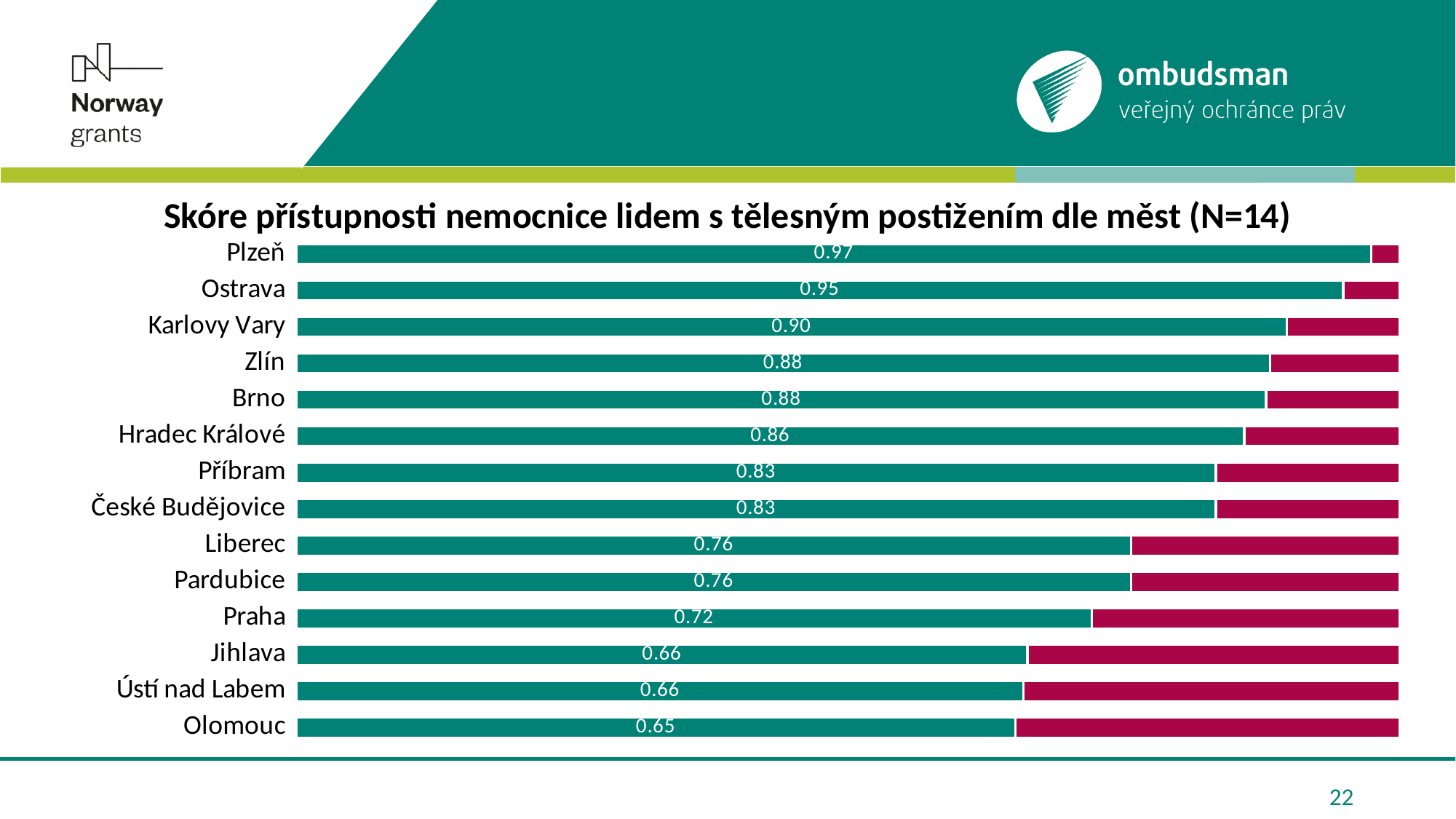
What is the accessibility score for Hradec Králové? 0.86 Which has a higher score, Příbram or Praha? Příbram How many cities are shown in the chart? 14 Which city has the highest accessibility score? Plzeň What is the difference between the scores of Ostrava and Karlovy Vary? 0.05 What is the accessibility score for Plzeň? 0.97 What kind of chart is shown on the slide? Bar chart What is the accessibility score for Praha? 0.72 Which has a higher score, Liberec or Jihlava? Liberec What is the title of the chart? Skóre přístupnosti nemocnice lidem s tělesným postižením dle měst (N=14) Which city has the lowest accessibility score? Olomouc What is the difference between the scores of Plzeň and Olomouc? 0.32